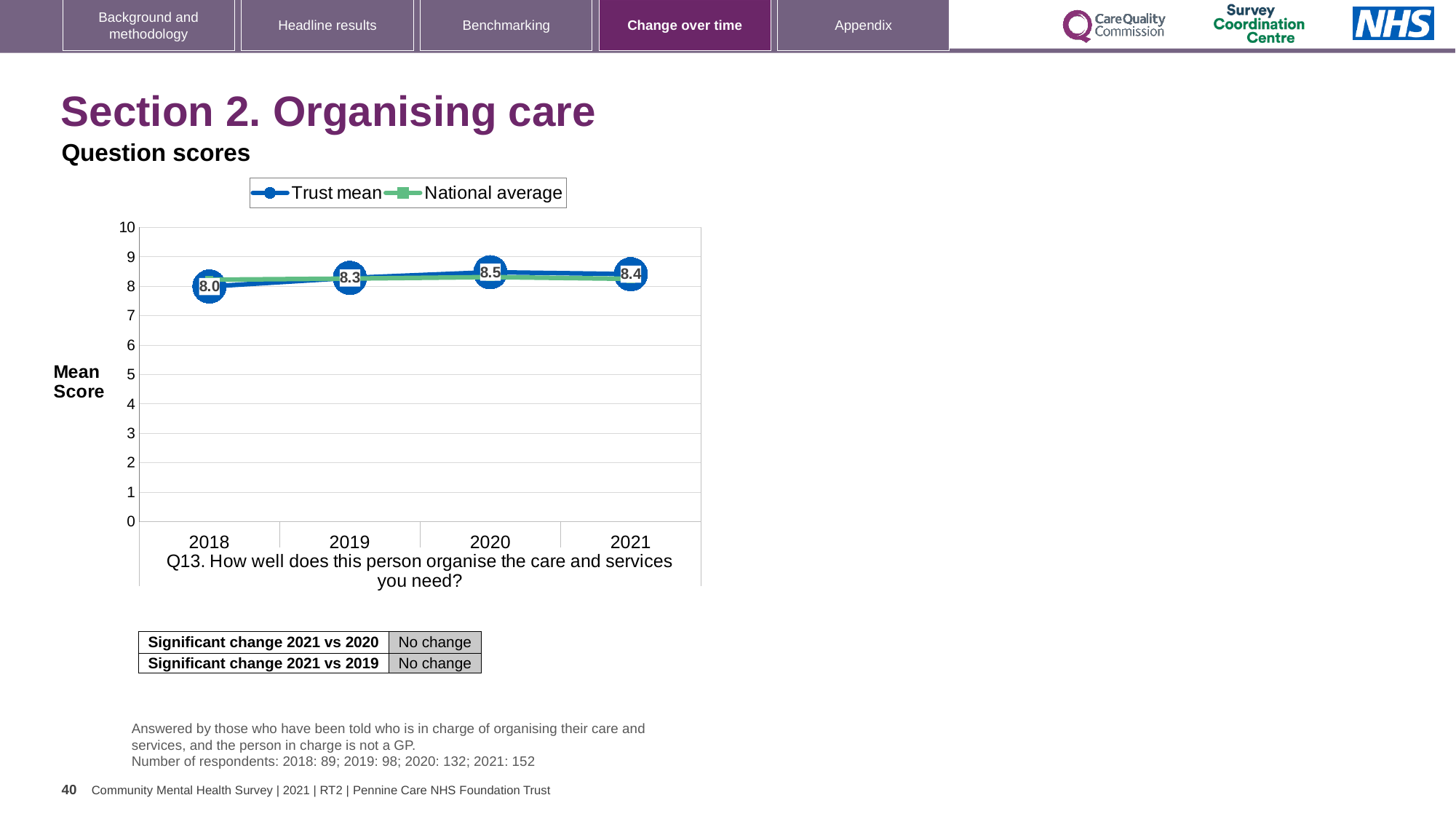
How many series does the legend list? 2 What is the Trust mean score for 2018? 8.0 What is the difference between the Trust mean in 2020 and in 2018? 0.5 Is the National average value for 2018 greater or less than 5? greater In which year is the Trust mean lowest? 2018 What is the Trust mean score for 2020? 8.5 What kind of chart is shown? Line chart Does the Trust mean rise or fall from 2018 to 2020? Rise What is the Trust mean score for 2021? 8.4 In which year is the Trust mean highest? 2020 How many years are shown on the x axis? 4 Which is larger, the Trust mean for 2019 or for 2021? 2021